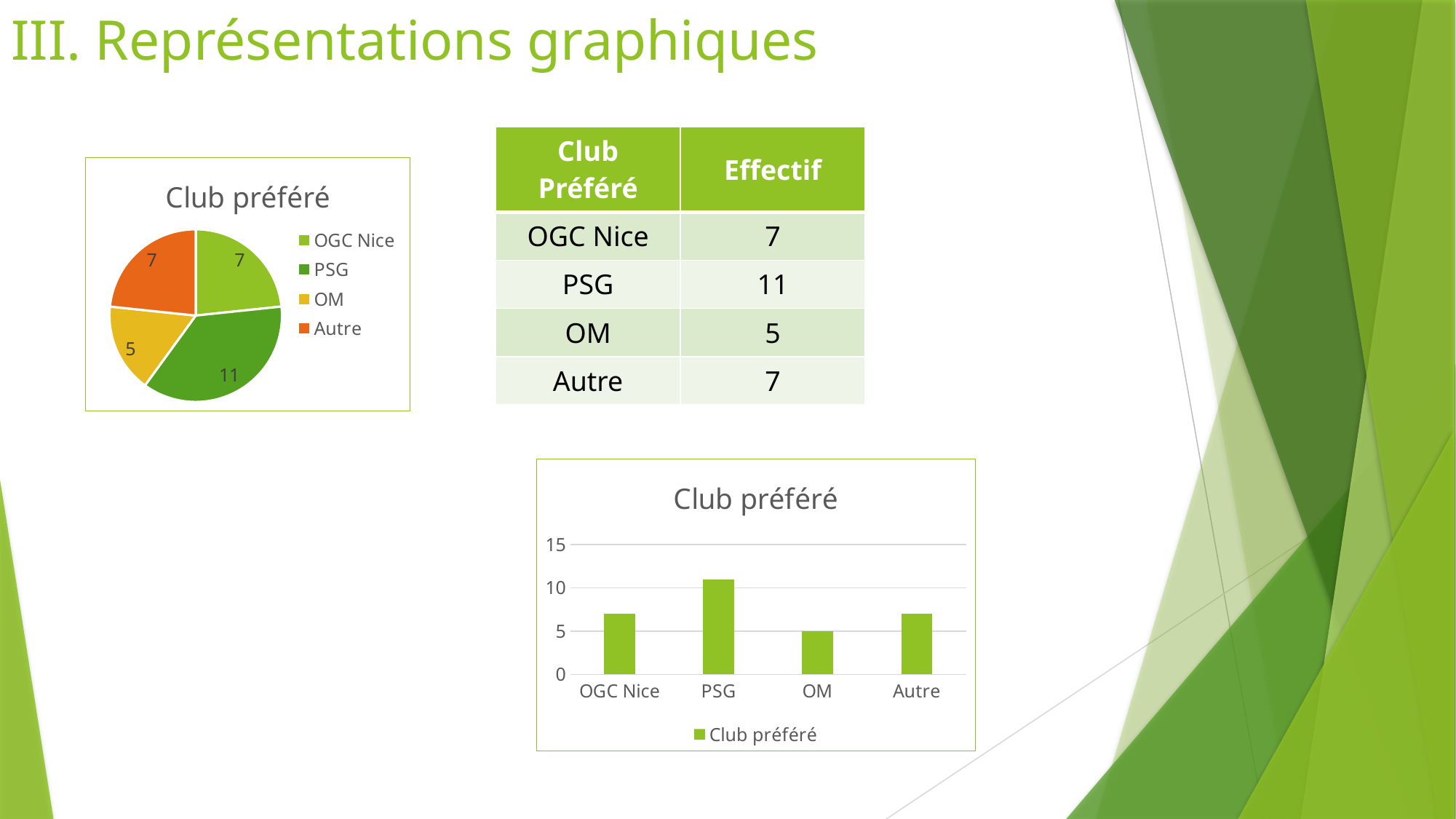
In the pie chart on the left, which colour is used for the Autre slice? Orange In the pie chart on the left, what is the difference between the values for PSG and OM? 6 In the bar chart at the bottom right, is the value for PSG greater or less than 10? greater In the pie chart titled 'Club préféré' on the left, what is the value for PSG? 11 How many series does the legend of the bar chart at the bottom right list? 1 In the bar chart at the bottom right, which category has the tallest bar? PSG In the pie chart on the left, which club has the largest slice? PSG In the pie chart on the left, how many slices are there? 4 In the pie chart on the left, which club has the smallest slice? OM What kind of chart is the bottom-right chart titled 'Club préféré'? Bar chart In the pie chart on the left, what is the value for OM? 5 In the bar chart at the bottom right, what is the value for OM? 5